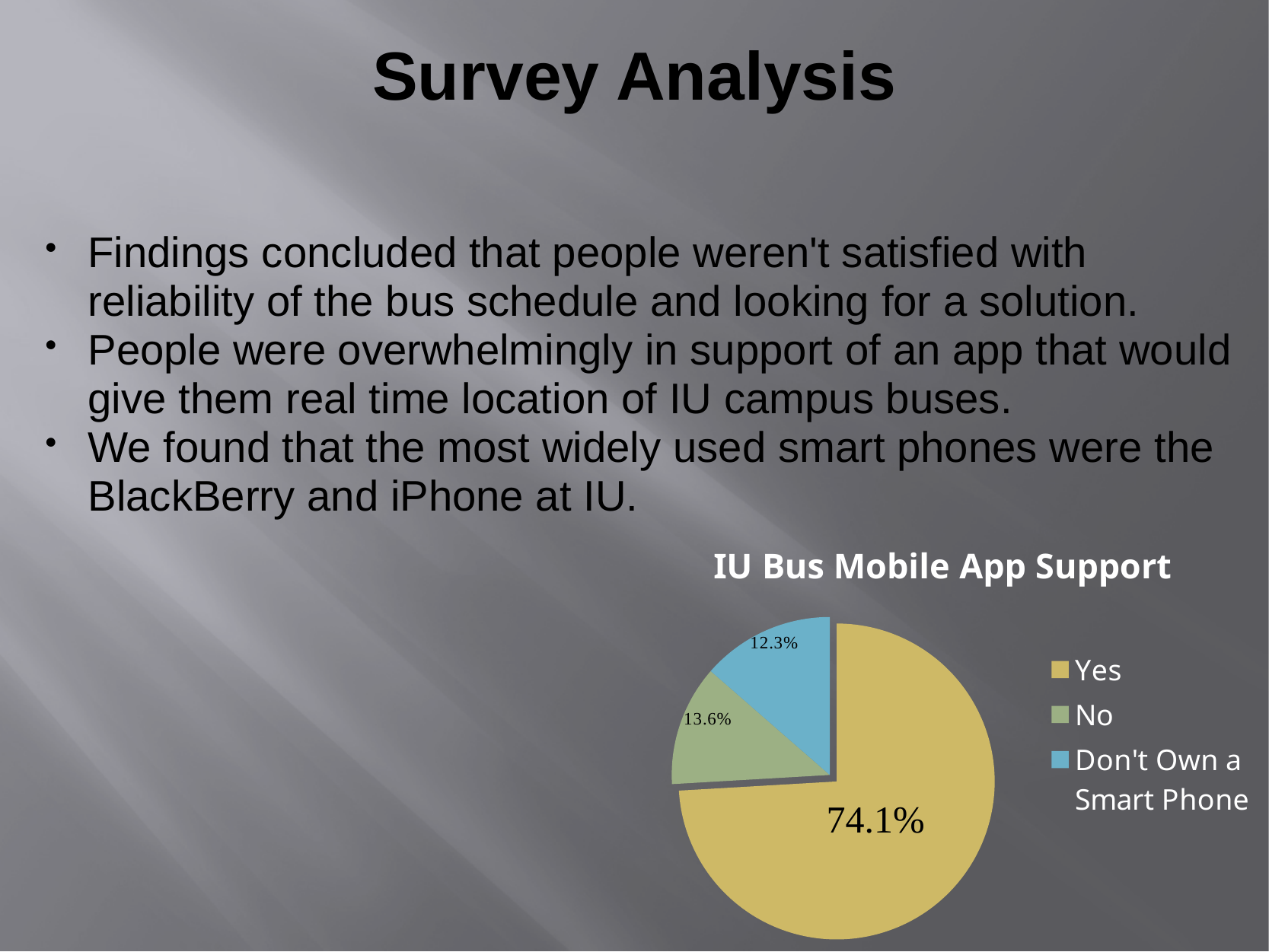
Which slice is larger, "No" or "Don't Own a Smart Phone"? Don't Own a Smart Phone What is the difference in percentage points between the "Yes" slice and the "No" slice? 61.8 What is the title of the chart? IU Bus Mobile App Support Which category has the largest slice of the pie? Yes How many entries does the legend list? 3 What percentage of the pie is the "Yes" slice? 74.1% What percentage of the pie is the "Don't Own a Smart Phone" slice? 13.6% What colour is the "Yes" slice in the pie chart? yellow What percentage of the pie is the "No" slice? 12.3% Which category has the smallest slice of the pie? No What type of chart is shown on the slide? pie chart How many slices does the pie chart have? 3